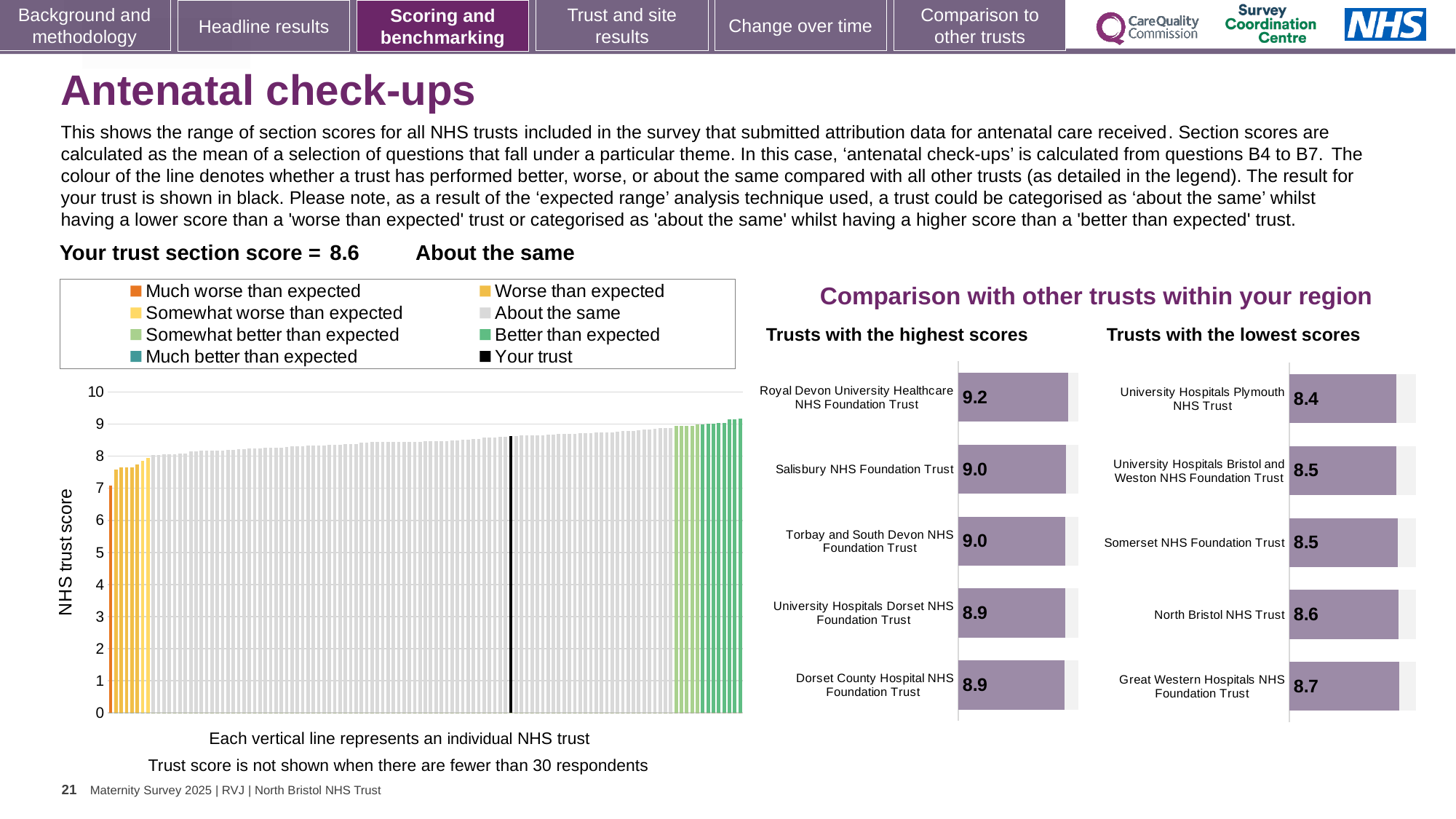
In the 'Trusts with the highest scores' chart, which has the higher score: Salisbury NHS Foundation Trust or University Hospitals Dorset NHS Foundation Trust? Salisbury NHS Foundation Trust In the 'Trusts with the lowest scores' chart, what is the score for University Hospitals Plymouth NHS Trust? 8.4 What kind of chart is the NHS trust score chart on the left of the slide? bar chart In the 'Trusts with the highest scores' chart, which trust has the highest score? Royal Devon University Healthcare NHS Foundation Trust In the 'Trusts with the lowest scores' chart, what is the difference between the scores of Great Western Hospitals NHS Foundation Trust and University Hospitals Plymouth NHS Trust? 0.3 In the 'Trusts with the highest scores' chart, what is the score for Royal Devon University Healthcare NHS Foundation Trust? 9.2 In the NHS trust score chart on the left, do the values rise or fall from left to right? rise In the 'Trusts with the lowest scores' chart, what is the score for North Bristol NHS Trust? 8.6 In the 'Trusts with the highest scores' chart, what is the difference between the scores of Royal Devon University Healthcare NHS Foundation Trust and Dorset County Hospital NHS Foundation Trust? 0.3 How many entries does the legend of the NHS trust score chart on the left list? 8 In the 'Trusts with the lowest scores' chart, which trust has the lowest score? University Hospitals Plymouth NHS Trust How many trusts are shown in the 'Trusts with the highest scores' chart? 5